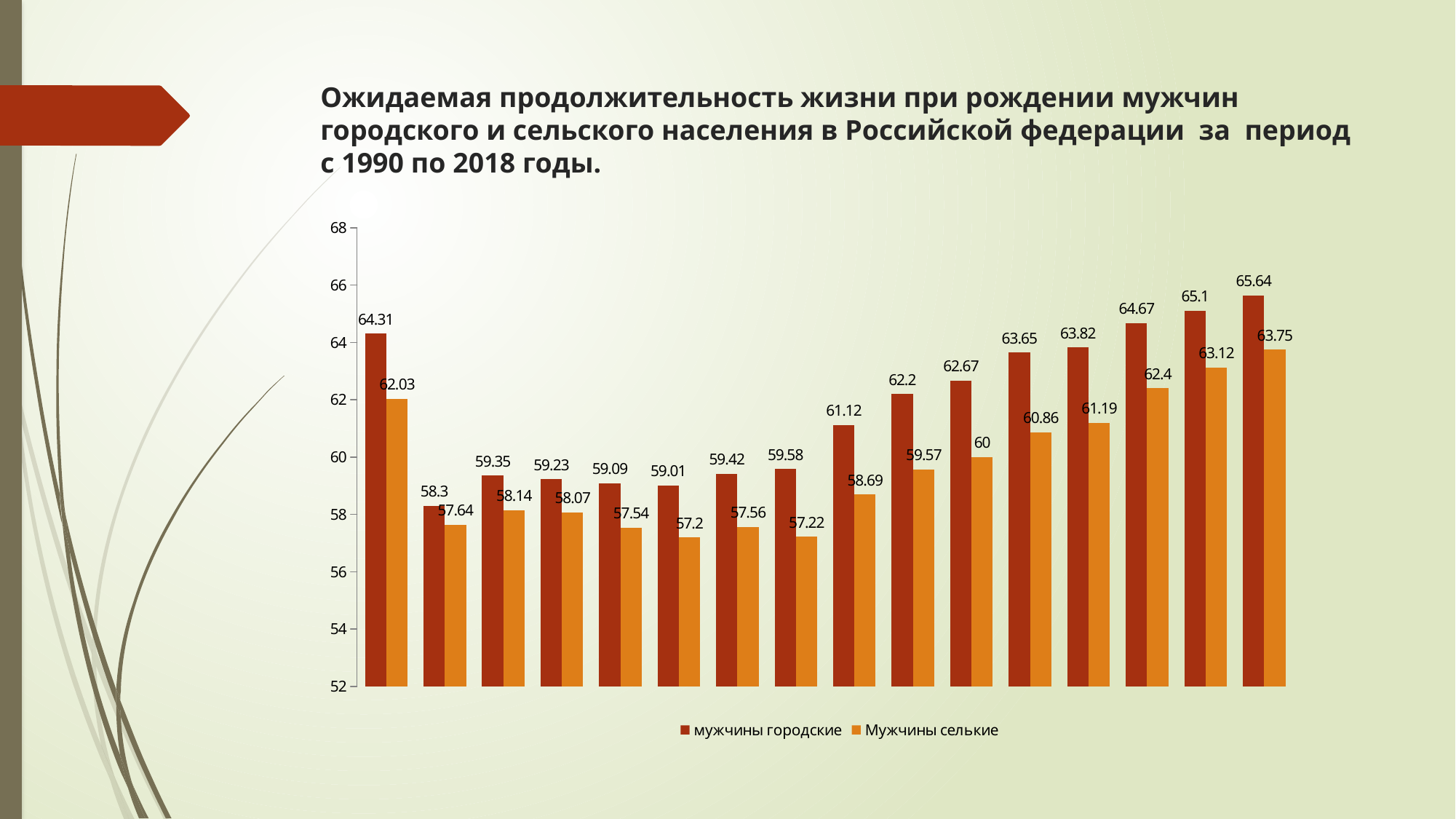
What colour are the bars for the series 'Мужчины селькие'? orange From the second group of bars onward, do the values for 'мужчины городские' generally rise or fall along the x axis? rise Is the value of the second 'мужчины городские' bar from the left (58.3) greater or less than 60? less In the leftmost group of bars, which series has the larger value, 'мужчины городские' or 'Мужчины селькие'? мужчины городские What is the difference between the two bars in the rightmost group (65.64 and 63.75)? 1.89 What kind of chart is shown on the slide? bar chart What is the lowest value shown for the series 'Мужчины селькие'? 57.2 How many groups of bars are plotted in the chart? 16 What is the highest value shown for the series 'мужчины городские'? 65.64 What is the value of the first (leftmost) bar for the series 'мужчины городские'? 64.31 How many series does the legend list? 2 What is the value of the last (rightmost) bar for the series 'Мужчины селькие'? 63.75